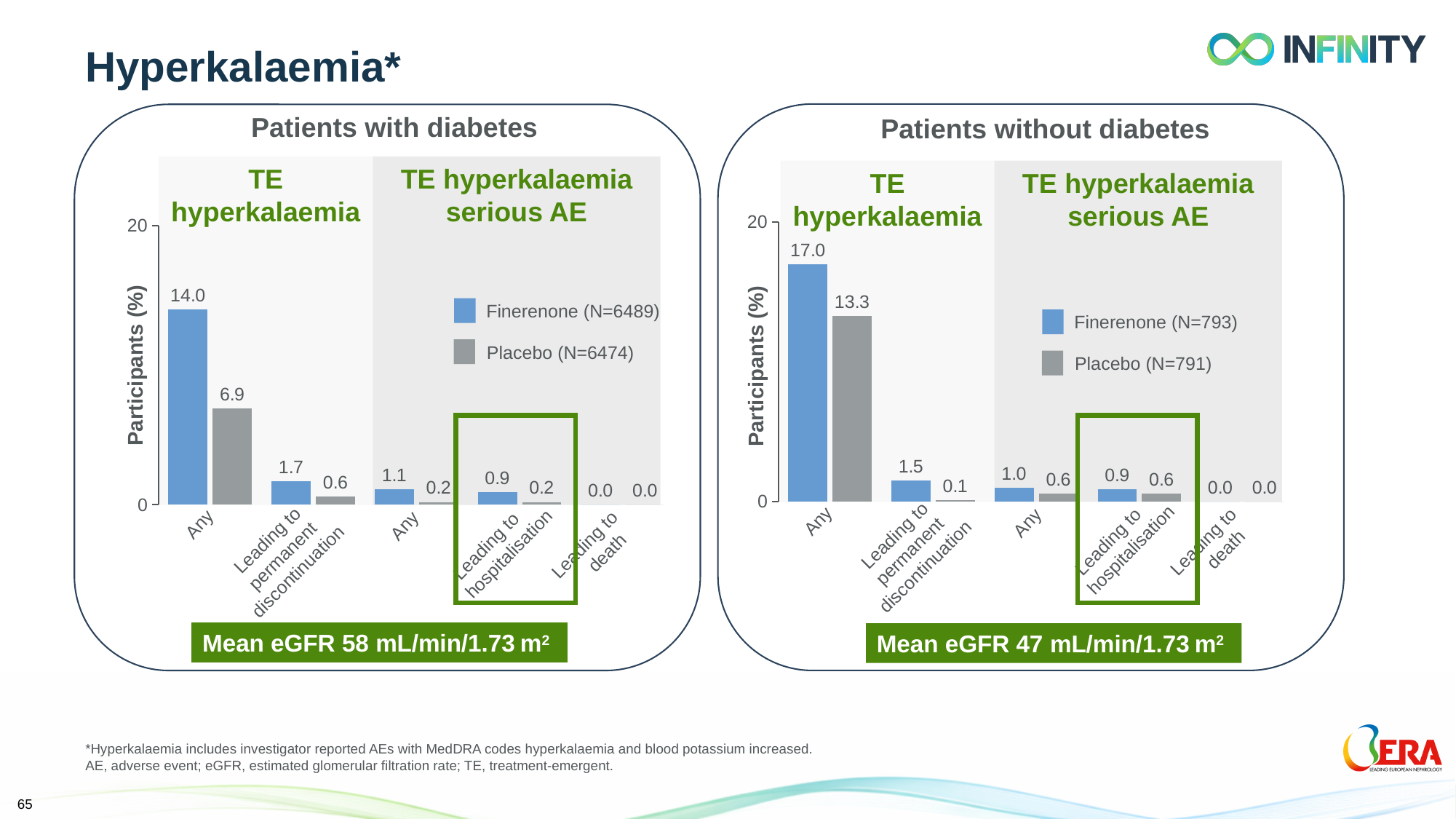
In the 'Patients with diabetes' chart, what is the Finerenone value for 'Any' TE hyperkalaemia? 14.0 In the 'Patients with diabetes' chart, what is the Placebo sample size shown in the legend? N=6474 In the 'Patients without diabetes' chart, what is the Placebo value for 'Any' TE hyperkalaemia? 13.3 How many series does the legend list in the 'Patients with diabetes' chart? 2 In the 'Patients with diabetes' chart, what is the difference between the Finerenone and Placebo values for 'Any' TE hyperkalaemia? 7.1 In the 'Patients without diabetes' chart, what is the Finerenone value for 'Leading to permanent discontinuation'? 1.5 In the 'Patients without diabetes' chart, what is the difference between the Finerenone and Placebo values for 'Any' TE hyperkalaemia? 3.7 In the 'Patients with diabetes' chart, which is larger for 'Any' TE hyperkalaemia serious AE: Finerenone or Placebo? Finerenone What mean eGFR is shown below the 'Patients without diabetes' chart? 47 mL/min/1.73 m² In the 'Patients with diabetes' chart, what is the Finerenone value for TE hyperkalaemia serious AE 'Leading to hospitalisation'? 0.9 In the 'Patients without diabetes' chart, which category has the highest Finerenone value? Any (TE hyperkalaemia) What type of chart is used in the 'Patients without diabetes' panel? Bar chart